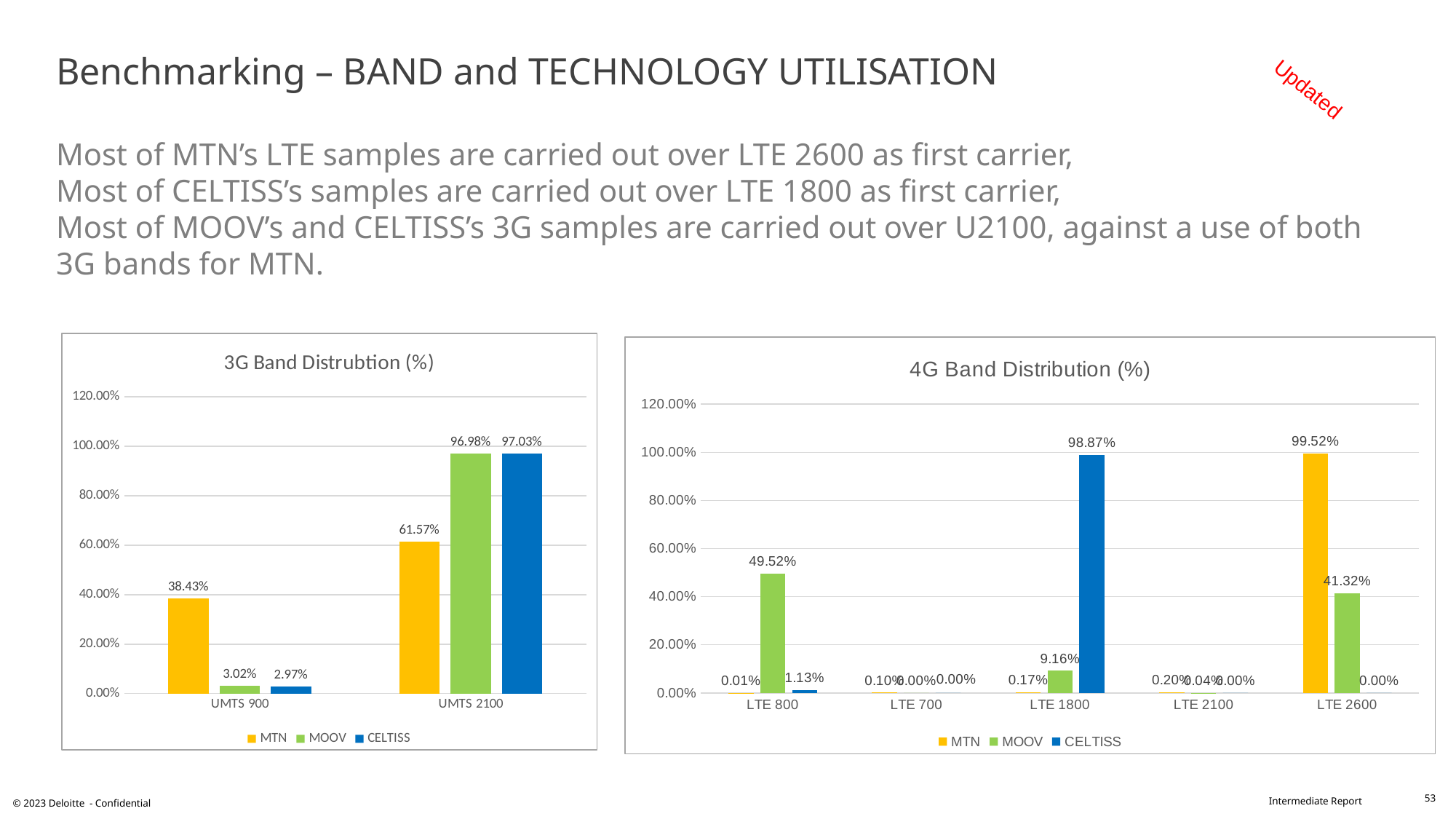
In the 3G Band Distribution chart, what is the value for CELTISS at UMTS 2100? 97.03% In the 3G Band Distribution chart, which operator has the highest value at UMTS 900? MTN In the 4G Band Distribution chart, which band has the highest value for MTN? LTE 2600 In the 3G Band Distribution chart, what is the difference between MOOV's UMTS 2100 value and its UMTS 900 value? 93.96% In the 3G Band Distribution chart, what is the value for MTN at UMTS 900? 38.43% In the 4G Band Distribution chart, what is the value for MOOV at LTE 800? 49.52% How many band categories are shown on the x axis of the 4G Band Distribution chart? 5 What type of chart is the 4G Band Distribution chart? bar chart In the 3G Band Distribution chart, how many series does the legend list? 3 In the 4G Band Distribution chart, is MOOV's value at LTE 2600 larger or smaller than its value at LTE 800? smaller In the 4G Band Distribution chart, what is the value for CELTISS at LTE 1800? 98.87% In the 4G Band Distribution chart, what is the difference between MTN's and MOOV's values at LTE 2600? 58.20%